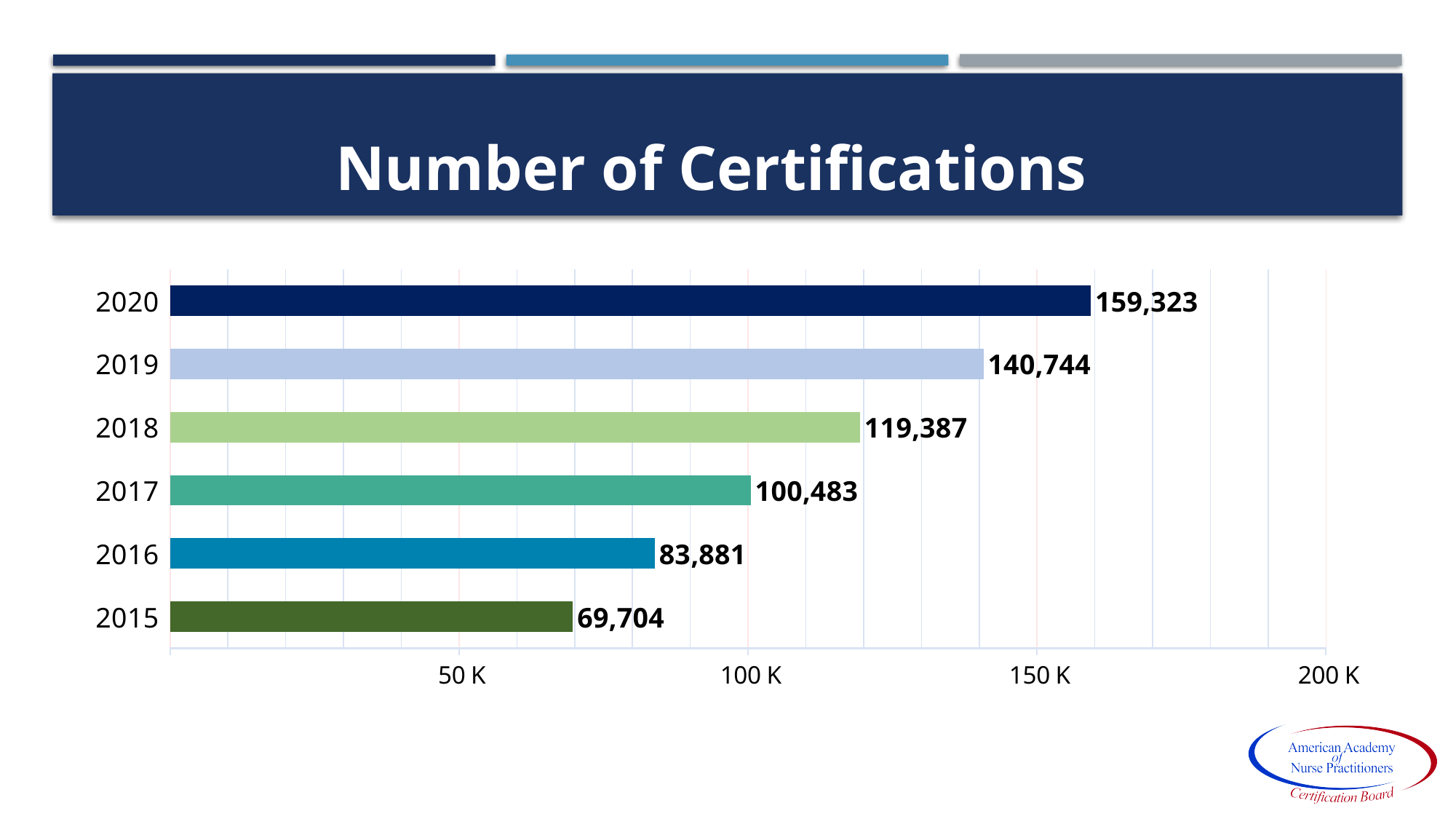
What is the number of certifications for 2020? 159,323 What is the number of certifications for 2017? 100,483 Which year has the lowest number of certifications? 2015 How many years are shown in the chart? 6 Which year has more certifications, 2018 or 2017? 2018 What is the number of certifications for 2015? 69,704 What kind of chart is shown on the slide? Bar chart What is the difference in certifications between 2016 and 2015? 14,177 What is the title of the chart? Number of Certifications Is the value for 2019 greater or less than 150 K? less Which year has the highest number of certifications? 2020 What is the difference in certifications between 2020 and 2019? 18,579